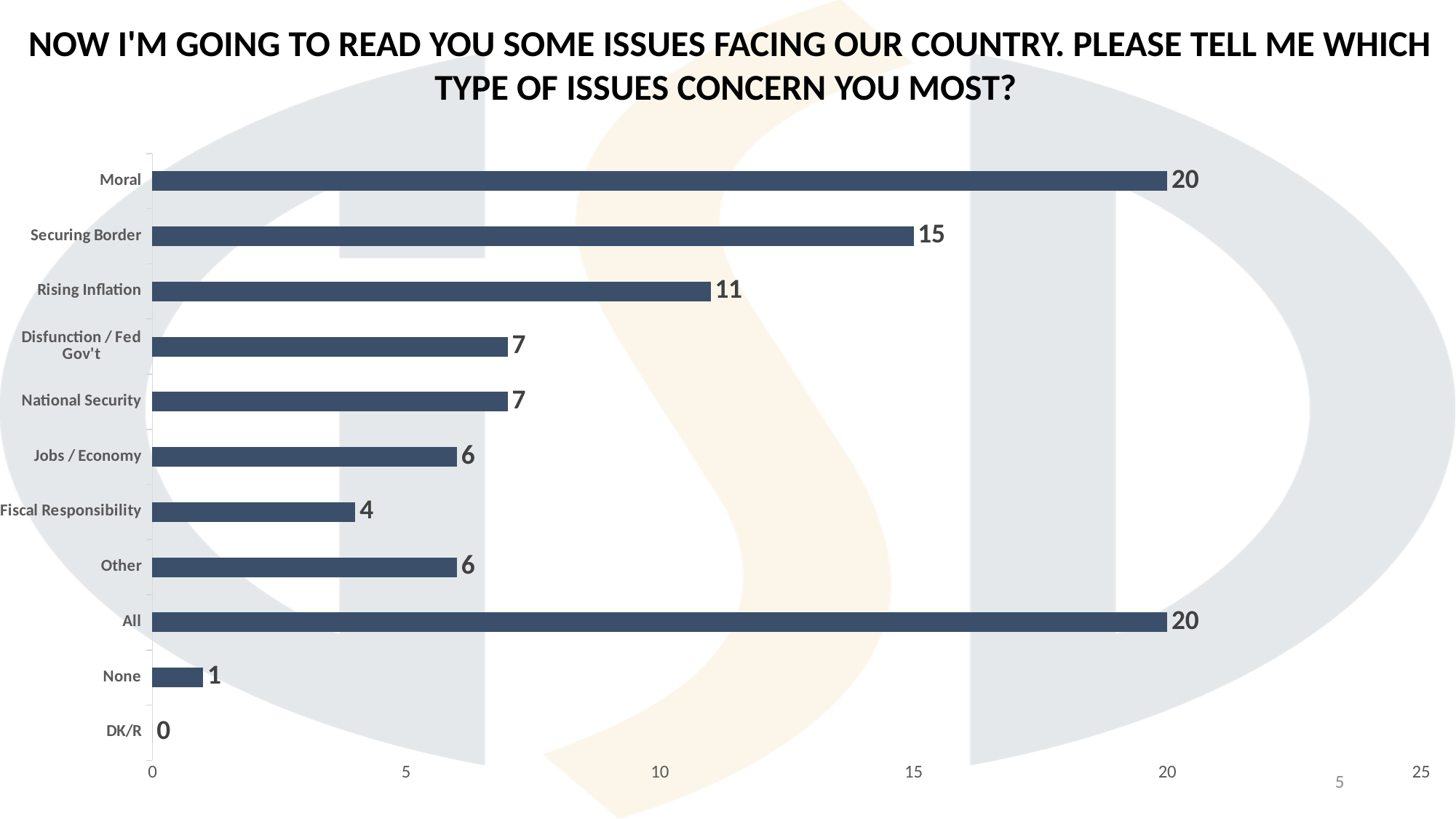
What is the value for Rising Inflation? 11 What kind of chart is shown on the slide? Bar chart What is the difference between the values for Moral and Securing Border? 5 What is the value for None? 1 How many categories are shown on the chart? 11 What is the value for Fiscal Responsibility? 4 Which is larger, the value for Securing Border or the value for Rising Inflation? Securing Border Which category has the lowest value? DK/R Is the value for Rising Inflation greater or less than 10? greater What is the highest value shown on the horizontal axis? 25 What is the value for Securing Border? 15 What is the difference between the values for Rising Inflation and Jobs / Economy? 5